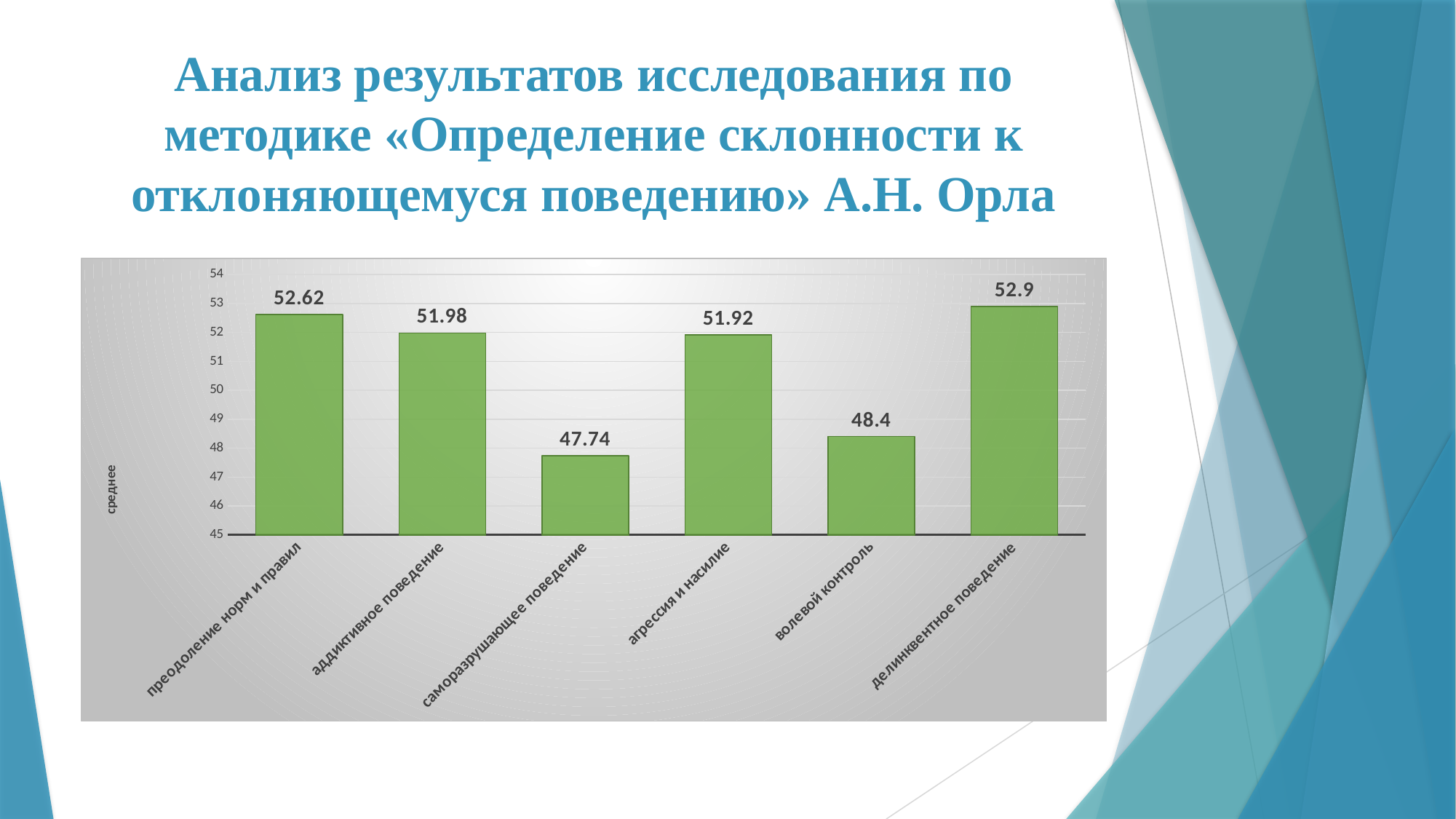
What is the value for «преодоление норм и правил»? 52.62 What is the value for «волевой контроль»? 48.4 What is the difference between the values for «делинквентное поведение» and «саморазрушающее поведение»? 5.16 Which category has the highest value? делинквентное поведение Is the value for «волевой контроль» greater or less than 50? less What kind of chart is shown on the slide? bar chart Which category has the lowest value? саморазрушающее поведение What is the value for «саморазрушающее поведение»? 47.74 How many categories are shown in the chart? 6 What is the difference between the values for «преодоление норм и правил» and «волевой контроль»? 4.22 What is the value for «делинквентное поведение»? 52.9 Which is larger, the value for «аддиктивное поведение» or the value for «волевой контроль»? аддиктивное поведение